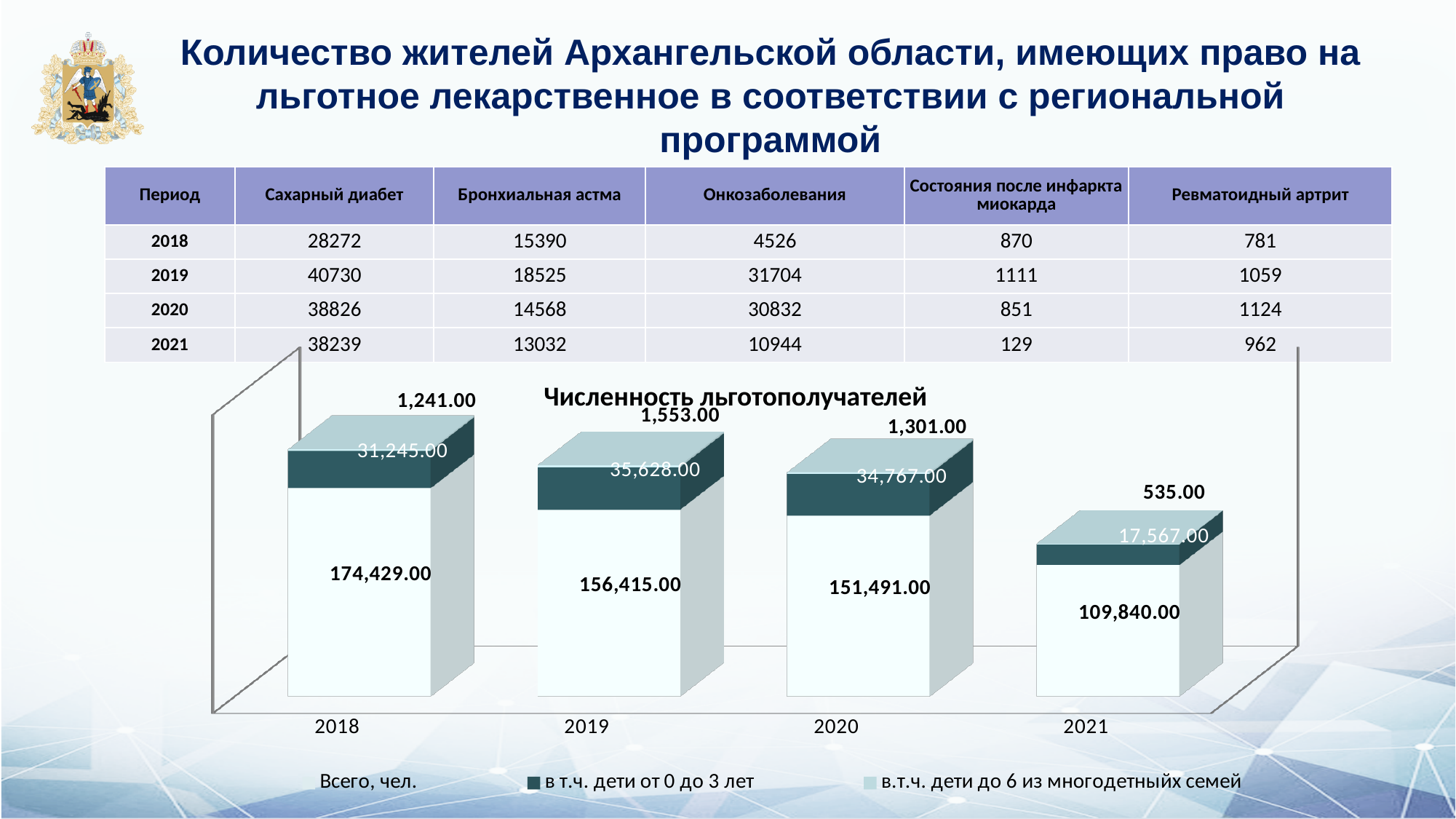
In the chart "Численность льготополучателей", which year has the lowest value for "в т.ч. дети от 0 до 3 лет"? 2021 In the chart "Численность льготополучателей", which year has the highest value for "Всего, чел."? 2018 How many years are shown on the x axis of the chart "Численность льготополучателей"? 4 In the chart "Численность льготополучателей", what is the value of "Всего, чел." for 2020? 151,491.00 In the chart "Численность льготополучателей", does the "Всего, чел." value rise or fall from 2018 to 2021? fall In the chart "Численность льготополучателей", what is the difference between the "Всего, чел." values for 2018 and 2021? 64,589.00 In the chart "Численность льготополучателей", what is the value of "в т.ч. дети до 6 из многодетныйх семей" for 2021? 535.00 What type of chart is "Численность льготополучателей"? bar chart In the chart "Численность льготополучателей", what is the value of "Всего, чел." for 2018? 174,429.00 In the chart "Численность льготополучателей", is the "в т.ч. дети до 6 из многодетныйх семей" value larger for 2019 or for 2020? 2019 How many series does the legend of the chart "Численность льготополучателей" list? 3 In the chart "Численность льготополучателей", what is the value of "в т.ч. дети от 0 до 3 лет" for 2019? 35,628.00